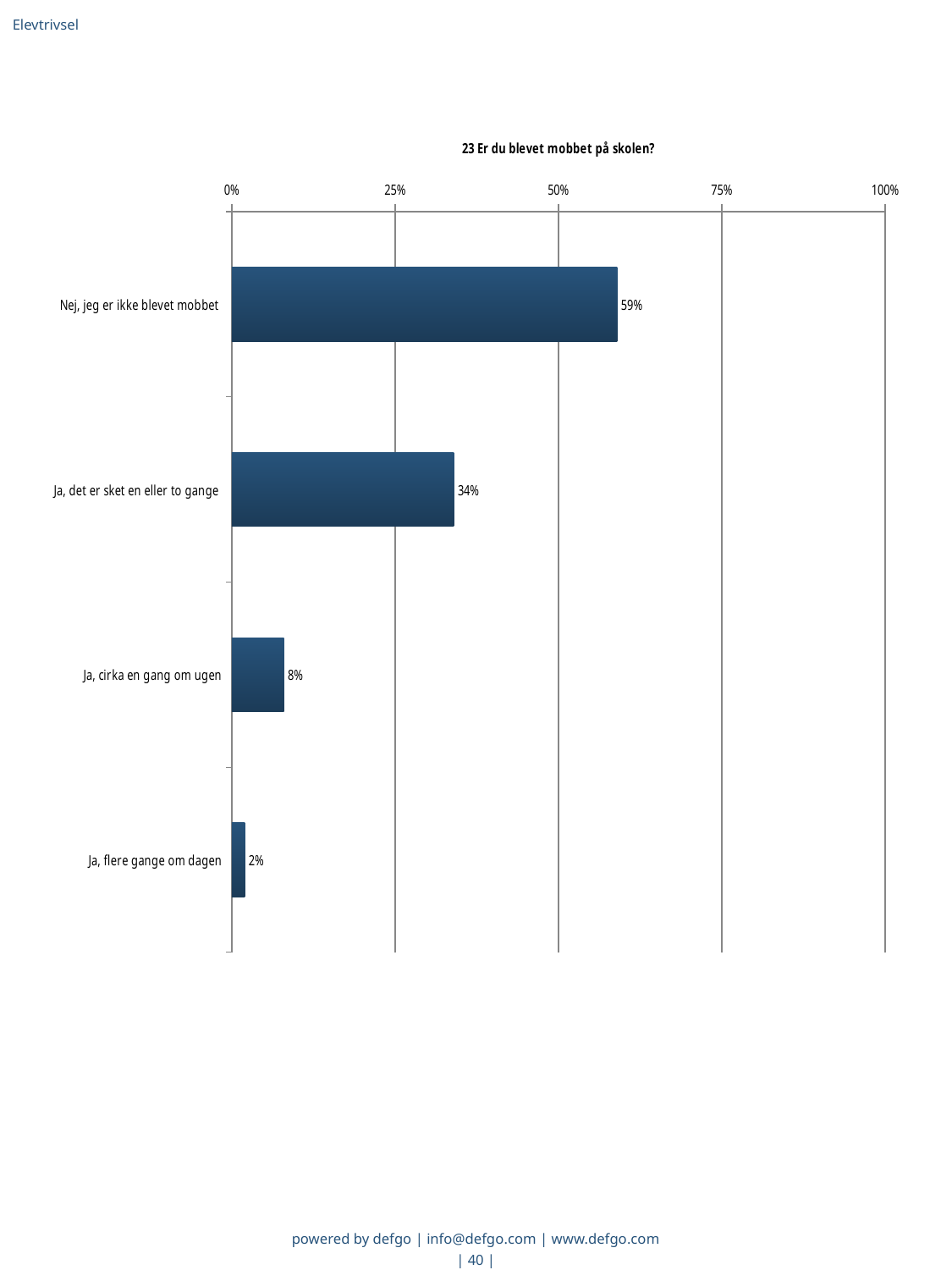
What is the difference between the values for "Nej, jeg er ikke blevet mobbet" and "Ja, det er sket en eller to gange"? 25% What is the value for "Ja, cirka en gang om ugen"? 8% What kind of chart is shown on the slide? bar chart What is the value for "Nej, jeg er ikke blevet mobbet"? 59% What is the title of the chart? 23 Er du blevet mobbet på skolen? How many categories are shown in the chart? 4 Which is larger: the value for "Ja, cirka en gang om ugen" or "Ja, flere gange om dagen"? Ja, cirka en gang om ugen Which category has the highest value? Nej, jeg er ikke blevet mobbet Is the value for "Nej, jeg er ikke blevet mobbet" greater or less than 50%? greater What is the value for "Ja, det er sket en eller to gange"? 34% What is the value for "Ja, flere gange om dagen"? 2% Which category has the lowest value? Ja, flere gange om dagen